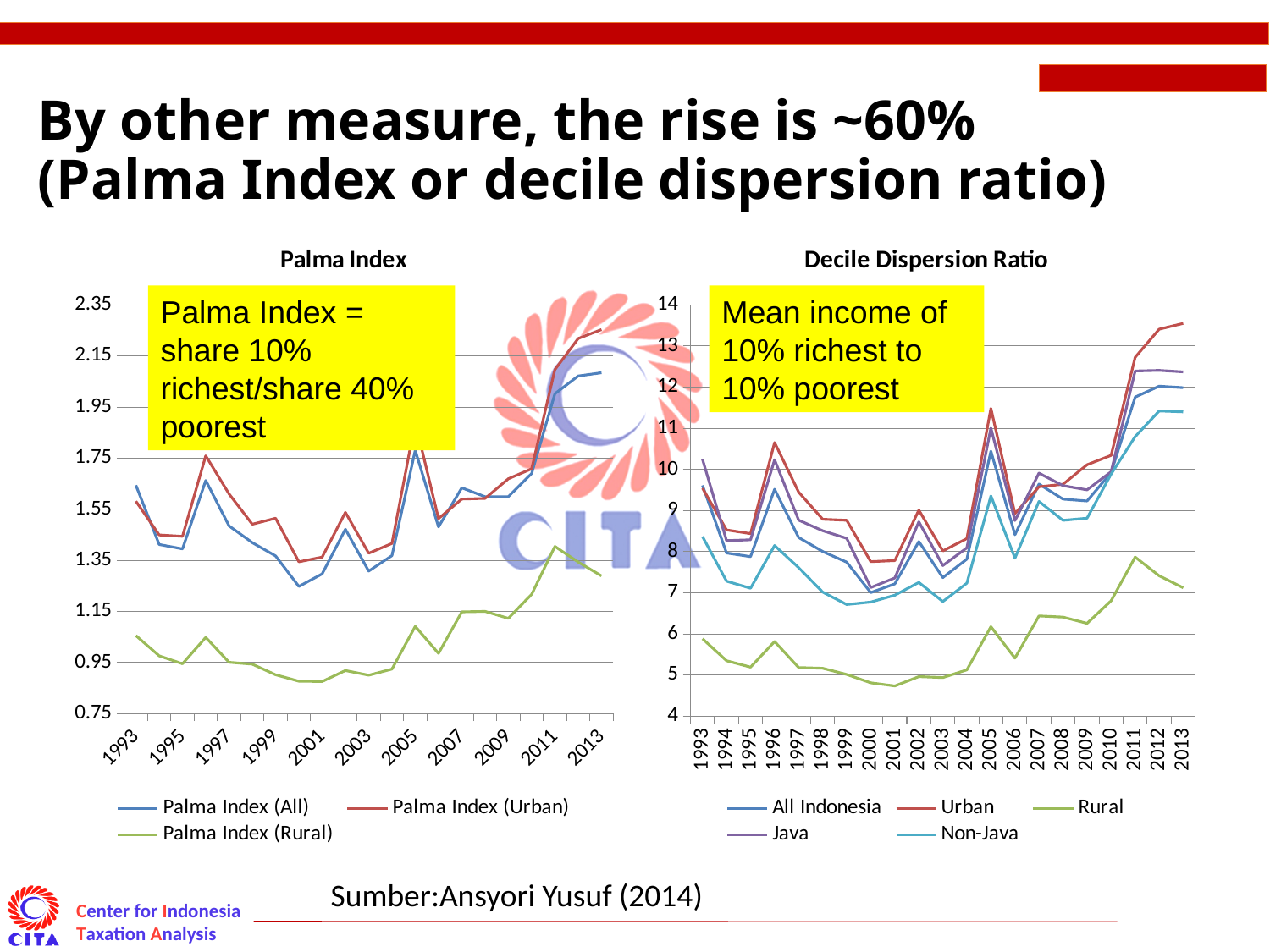
In the Decile Dispersion Ratio chart, is the value for Urban in 2013 greater or less than 13? greater In the Palma Index chart, which is larger in 2013: Palma Index (Urban) or Palma Index (Rural)? Palma Index (Urban) How many series does the legend of the Decile Dispersion Ratio chart list? 5 In the Decile Dispersion Ratio chart, does the Urban series rise or fall overall from 1993 to 2013? rise In the Decile Dispersion Ratio chart, which series has the highest value in 2013? Urban In the Palma Index chart, is the value for Palma Index (Urban) in 2013 greater or less than 2.15? greater What kind of chart is the Palma Index chart? line chart In the Palma Index chart, is the value for Palma Index (Rural) in 2001 greater or less than 0.95? less How many series does the legend of the Palma Index chart list? 3 In the Decile Dispersion Ratio chart, which series has the lowest value in 2013? Rural In the Decile Dispersion Ratio chart, how many years are shown on the x axis? 21